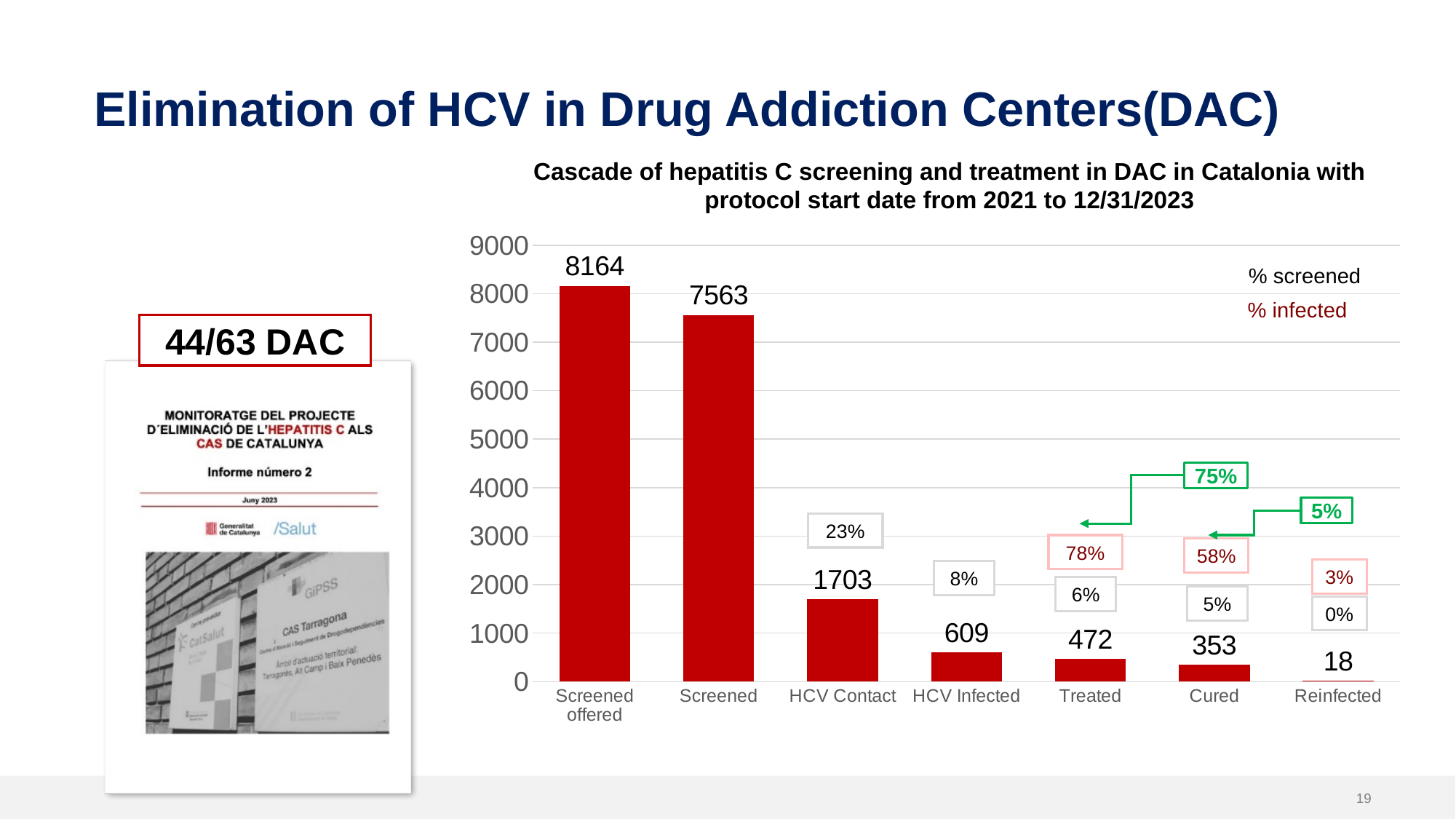
What is the value for 'HCV Infected'? 609 Which category has the lowest value? Reinfected What is the value for 'Cured'? 353 How many categories are shown on the x axis? 7 What is the difference between 'Treated' and 'Cured'? 119 Which category has the highest value? Screened offered Which is larger, 'HCV Contact' or 'HCV Infected'? HCV Contact What kind of chart is this? Bar chart What is the value for 'Screened'? 7563 What is the difference between 'Screened offered' and 'Screened'? 601 Do the values rise or fall from left to right along the x axis? Fall What is the value for 'Screened offered'? 8164